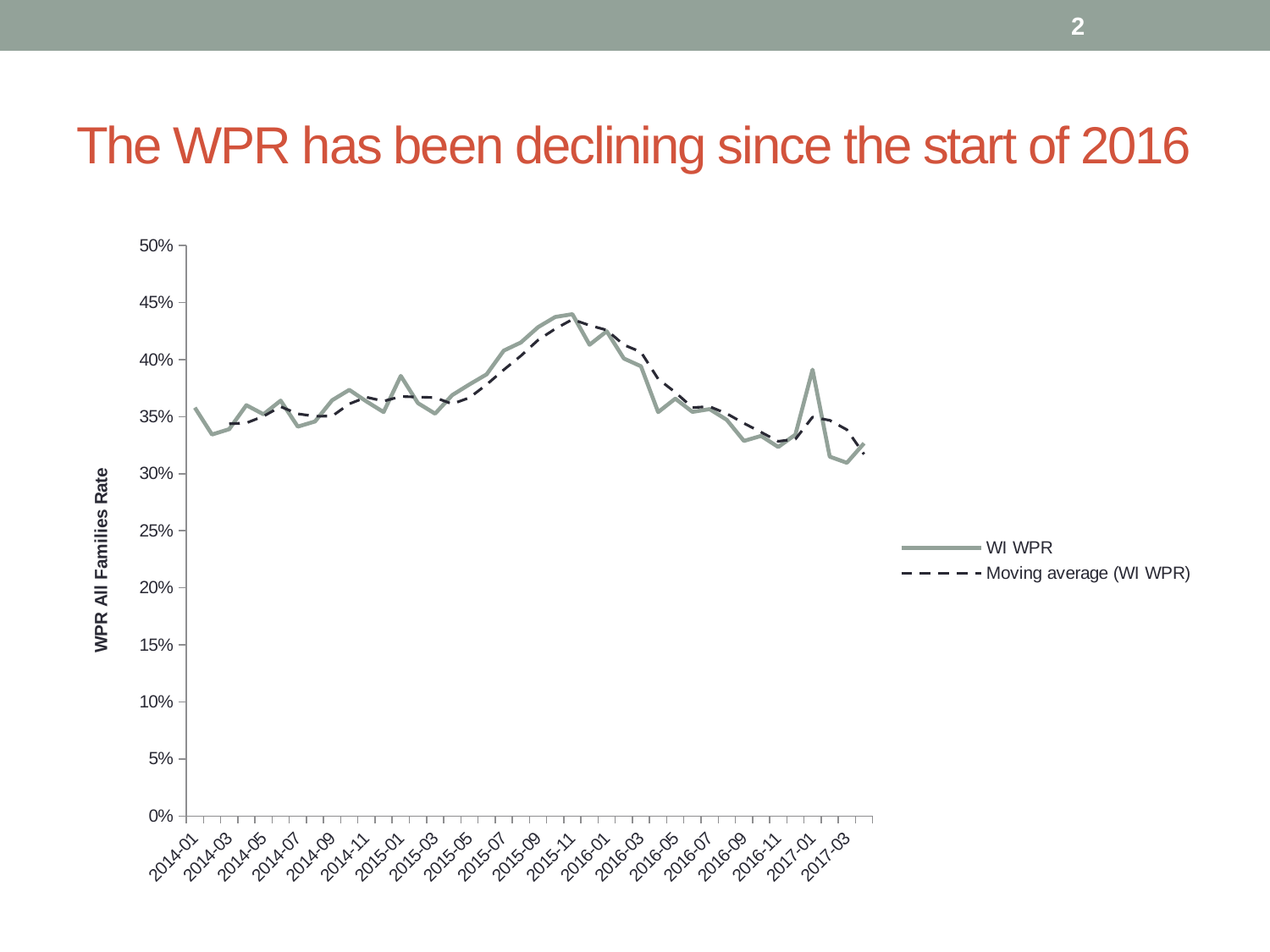
Is the WI WPR value for 2014-01 greater or less than 30%? greater Is the WI WPR value for 2017-01 greater or less than 35%? greater What is the highest value shown on the vertical axis? 50% What kind of chart is shown on the slide? Line chart Does the WI WPR series generally rise or fall between 2016-01 and 2017-03? Fall What is the label on the vertical axis? WPR All Families Rate Which is larger for the WI WPR series: the value at 2015-11 or the value at 2014-01? 2015-11 Around which month does the WI WPR series reach its highest point? 2015-11 Is the WI WPR value for 2016-09 greater or less than 35%? less How many series does the legend list? 2 What are the two series named in the legend? WI WPR and Moving average (WI WPR)